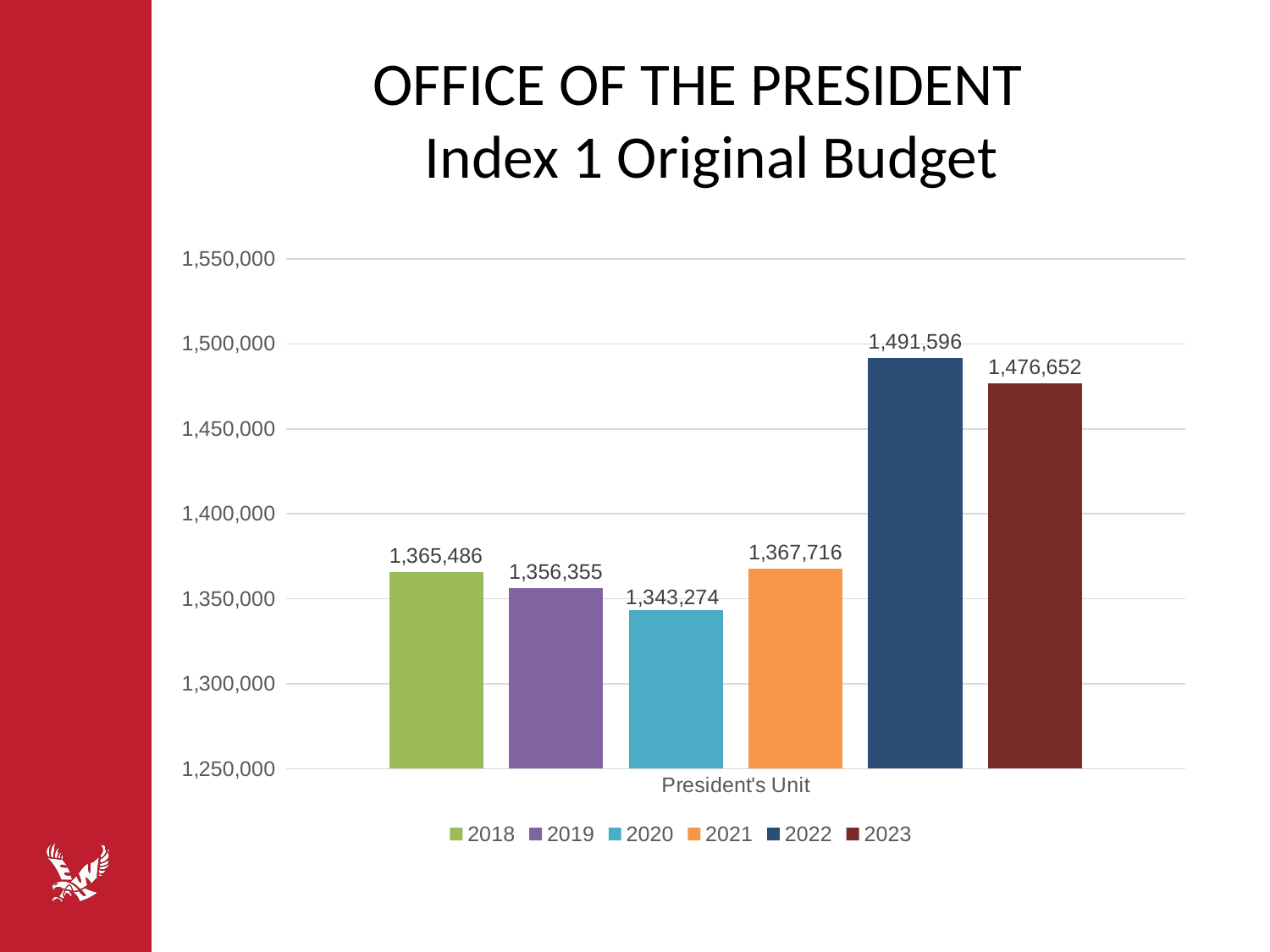
What is the value for 2022? 1,491,596 What is the difference between the values for 2021 and 2020? 24,442 What is the difference between the values for 2022 and 2023? 14,944 Is the value for 2023 greater or less than 1,450,000? greater Which year has the lowest value? 2020 What is the value for 2018? 1,365,486 Which is larger, the value for 2019 or the value for 2021? 2021 How many series does the legend list? 6 What is the value for 2020? 1,343,274 What is the label on the x axis of the chart? President's Unit Which year has the highest value? 2022 What kind of chart is shown on the slide? bar chart